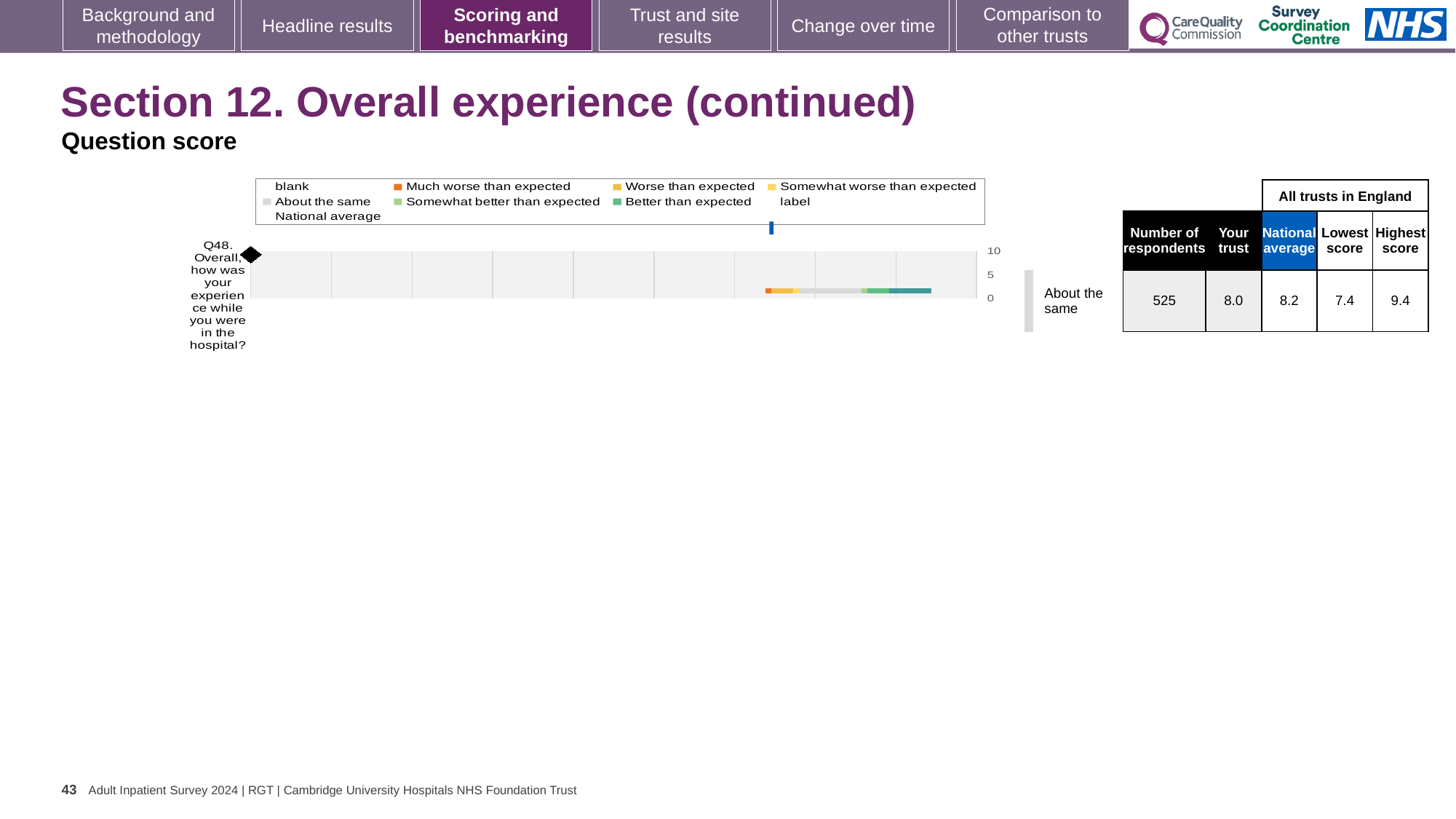
Which is larger for Q48, the 'Your trust' score or the national average? National average According to the table beside the chart, what is the national average score for Q48? 8.2 How many questions (categories) are plotted on the chart? 1 According to the table beside the chart, what is the 'Your trust' score for Q48? 8.0 What kind of chart is shown on the slide? Bar chart How is the trust's result for Q48 categorised relative to other trusts? About the same According to the table beside the chart, how many respondents answered Q48? 525 Is the national average marker on the chart greater or less than 5? greater Which question is plotted on the chart? Q48. Overall, how was your experience while you were in the hospital? What is the difference between the highest score and the lowest score for Q48 in the table beside the chart? 2.0 What is the highest value shown on the chart's axis? 10